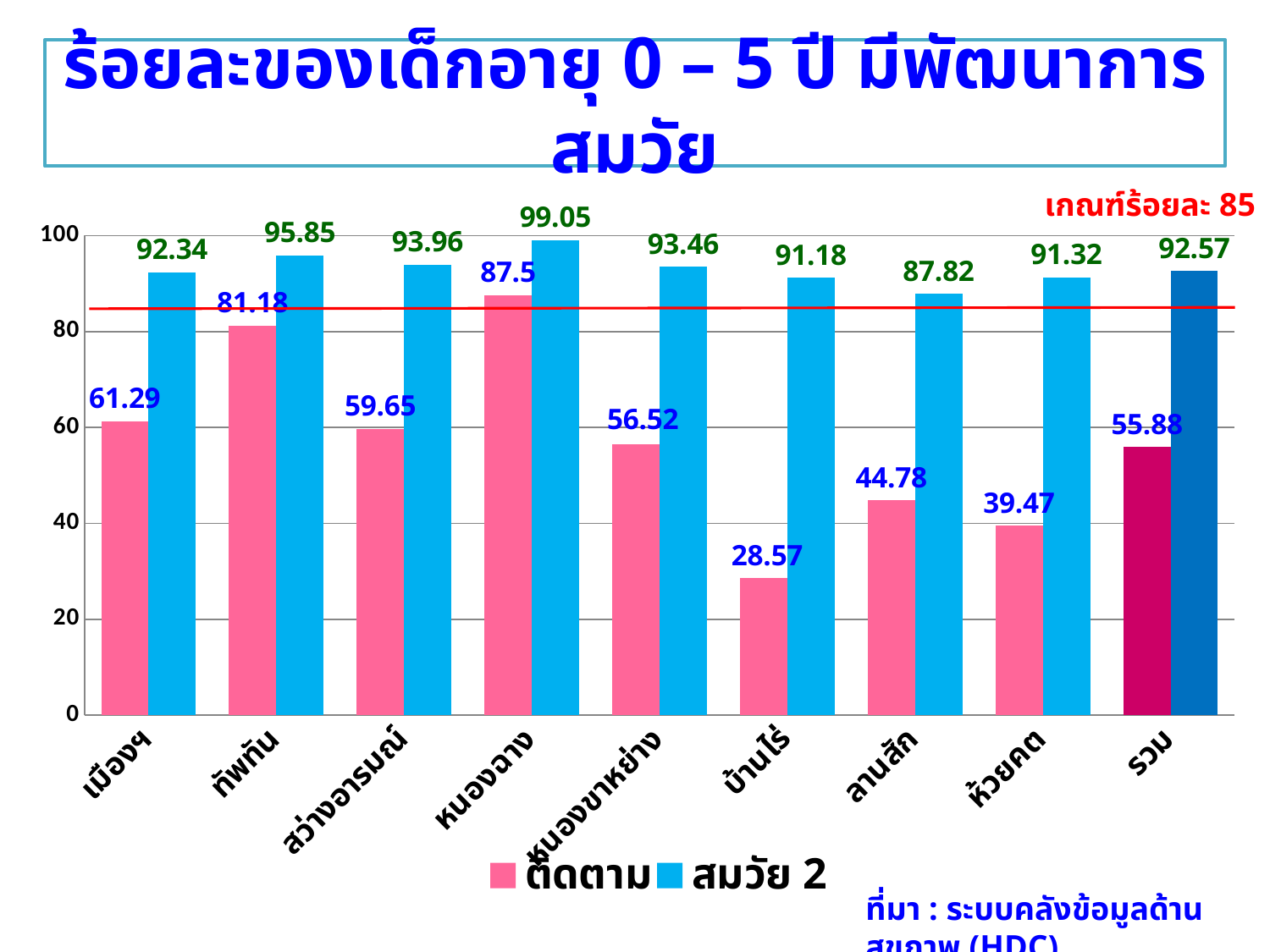
What is the value of ติดตาม for บ้านไร่? 28.57 What threshold value does the red horizontal line on the chart represent? 85 What is the value of ติดตาม for รวม? 55.88 What is the difference between the สมวัย 2 and ติดตาม values for ห้วยคต? 51.85 Which series is shown in pink in the legend? ติดตาม Which is larger, the ติดตาม value for ทัพทัน or the ติดตาม value for เมืองฯ? ทัพทัน Which category has the lowest สมวัย 2 value? ลานสัก What is the value of สมวัย 2 for หนองฉาง? 99.05 How many categories are shown on the x axis? 9 What type of chart is shown on the slide? bar chart How many series does the legend list? 2 Which category has the highest ติดตาม value? หนองฉาง